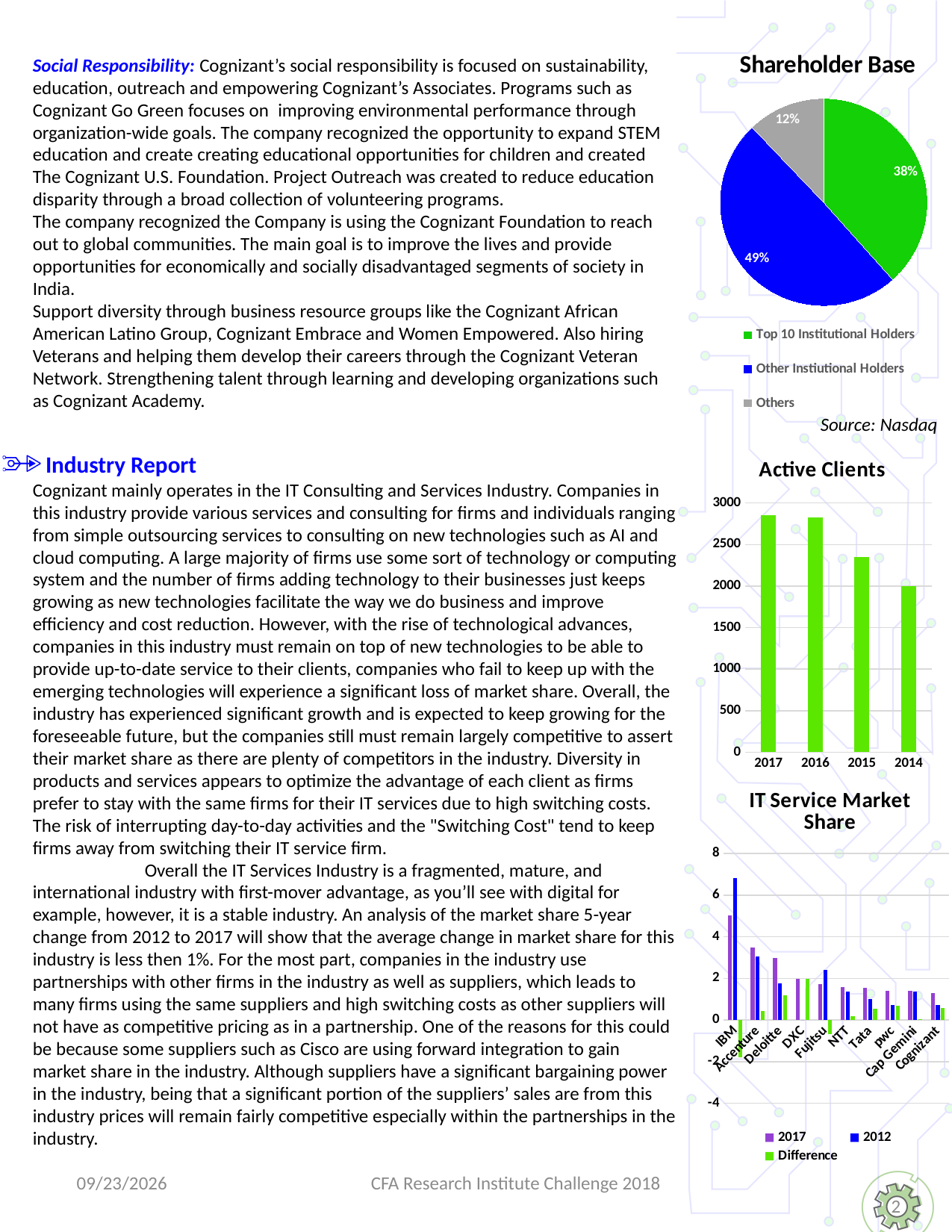
How many series does the legend of the IT Service Market Share chart list? 3 How many years are shown in the Active Clients chart? 4 In the Active Clients chart, which year has the lowest number of active clients? 2014 In the Shareholder Base chart, which group has the smallest slice? Others In the IT Service Market Share chart, which company has the highest 2012 value? IBM In the Shareholder Base chart, what share do the Top 10 Institutional Holders hold? 38% In the Active Clients chart, is the value for 2014 greater or less than 2500? less In the Active Clients chart, is the value for 2017 greater or less than 2500? greater In the Shareholder Base chart, how many percentage points larger is the Other Institutional Holders slice than the Top 10 Institutional Holders slice? 11% In the Shareholder Base chart, what share do Other Institutional Holders hold? 49% What kind of chart is the Active Clients chart? bar chart In the Shareholder Base chart, which group has the largest slice? Other Institutional Holders